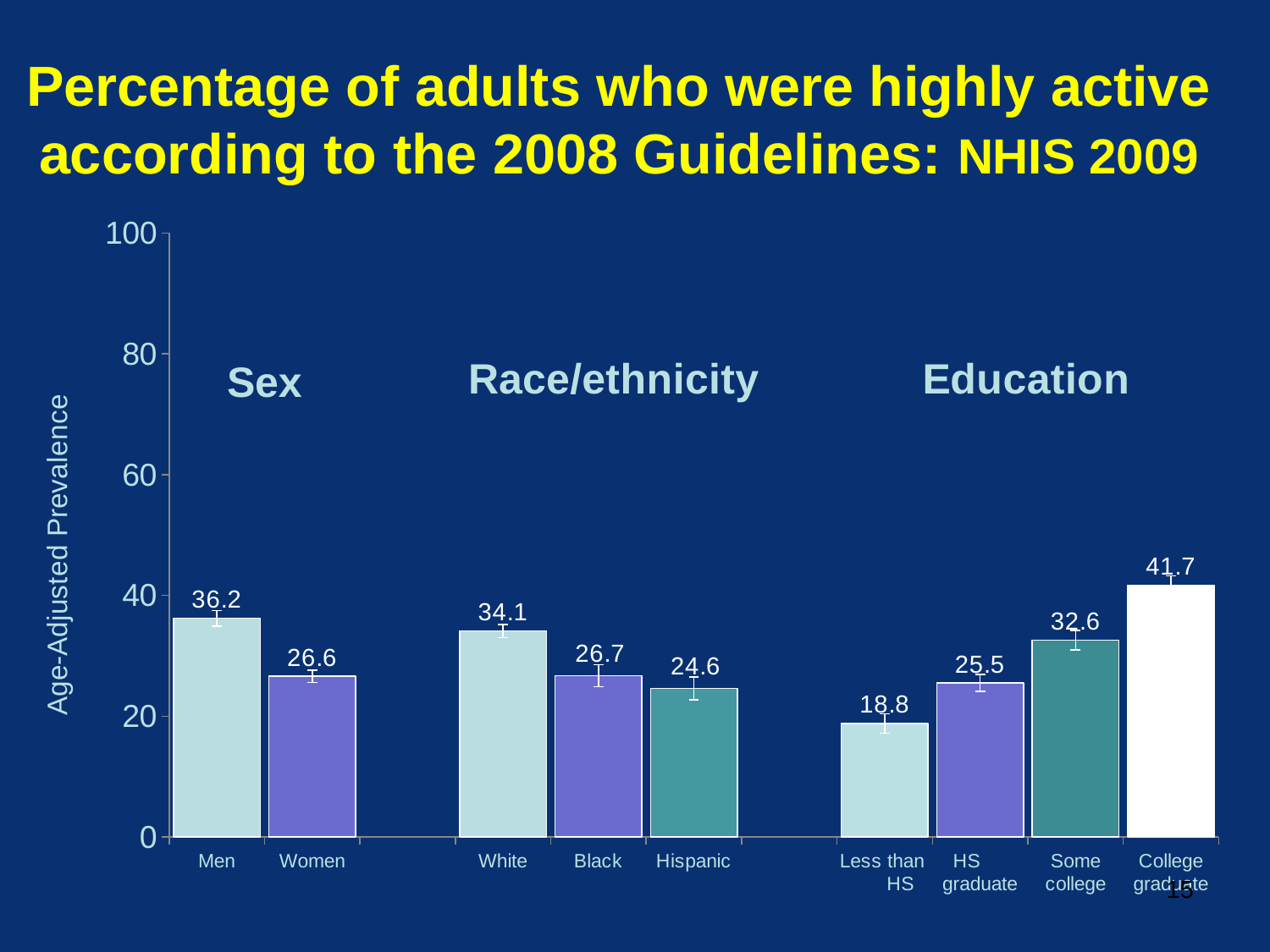
What is the age-adjusted prevalence for Hispanic adults? 24.6 Which category has the lowest value on the chart? Less than HS What kind of chart is shown on the slide? bar chart Which is larger, the value for White or the value for Black? White Is the value for Some college greater or less than 40? less What is the difference between the values for College graduate and Less than HS? 22.9 What is the label of the y axis? Age-Adjusted Prevalence What is the difference between the values for Men and Women? 9.6 How many categories are plotted on the chart? 9 What is the age-adjusted prevalence for Men? 36.2 What is the value shown for College graduate? 41.7 Which category has the highest value on the chart? College graduate